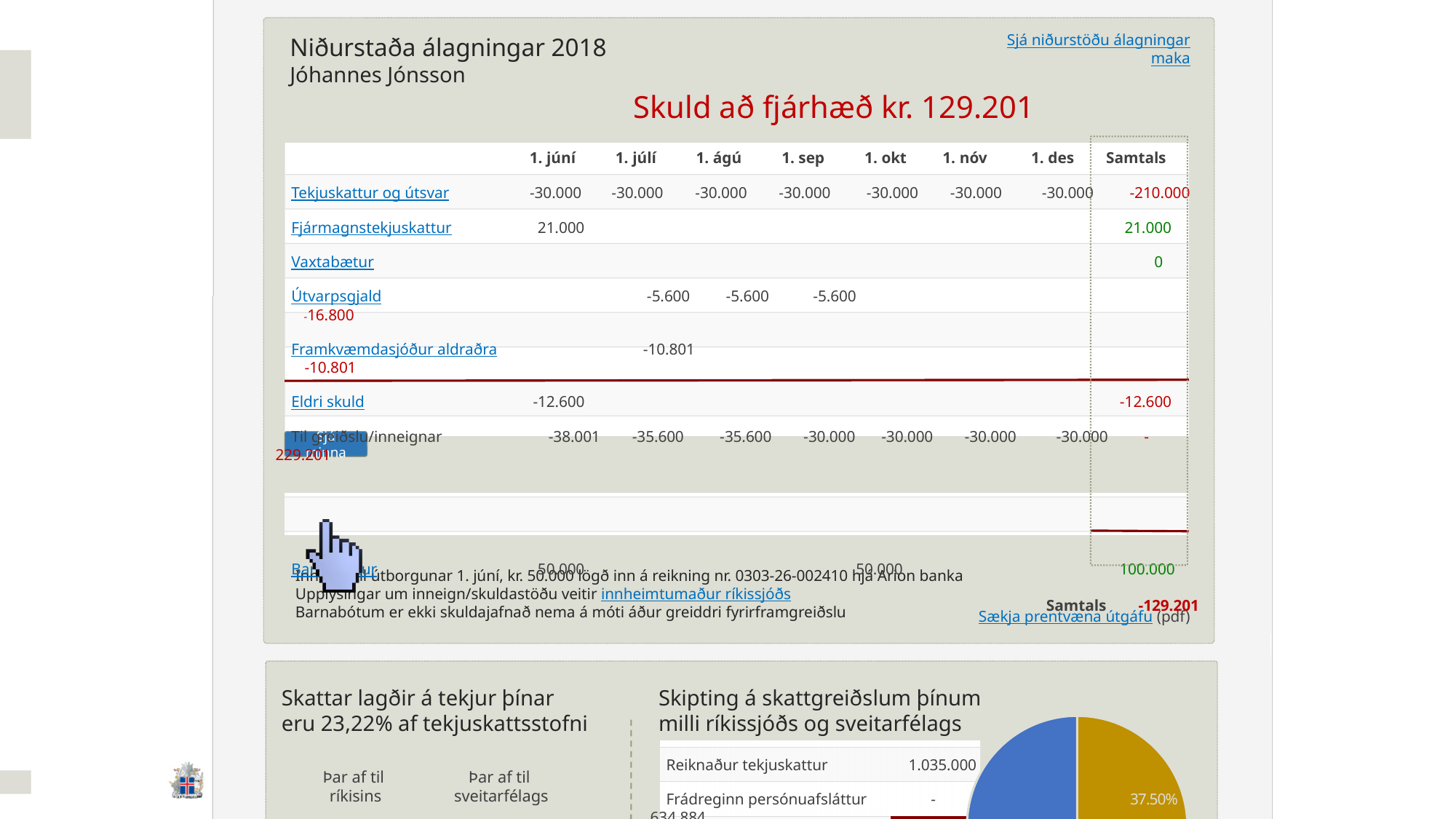
In the pie chart at the bottom right of the slide, what share of the pie does the gold slice represent? 37.50% What two colours are used for the slices of the pie chart at the bottom right of the slide? blue and gold What kind of chart is shown at the bottom right of the slide, under the heading "Skipting á skattgreiðslum þínum milli ríkissjóðs og sveitarfélags"? pie chart In the pie chart at the bottom right of the slide, which slice is larger, the blue one or the gold one? the blue one In the pie chart at the bottom right of the slide, what percentage is printed on the gold slice? 37.50% What is the heading printed above the pie chart at the bottom right of the slide? Skipting á skattgreiðslum þínum milli ríkissjóðs og sveitarfélags In the pie chart at the bottom right of the slide, is the gold slice's share greater or less than 50%? less